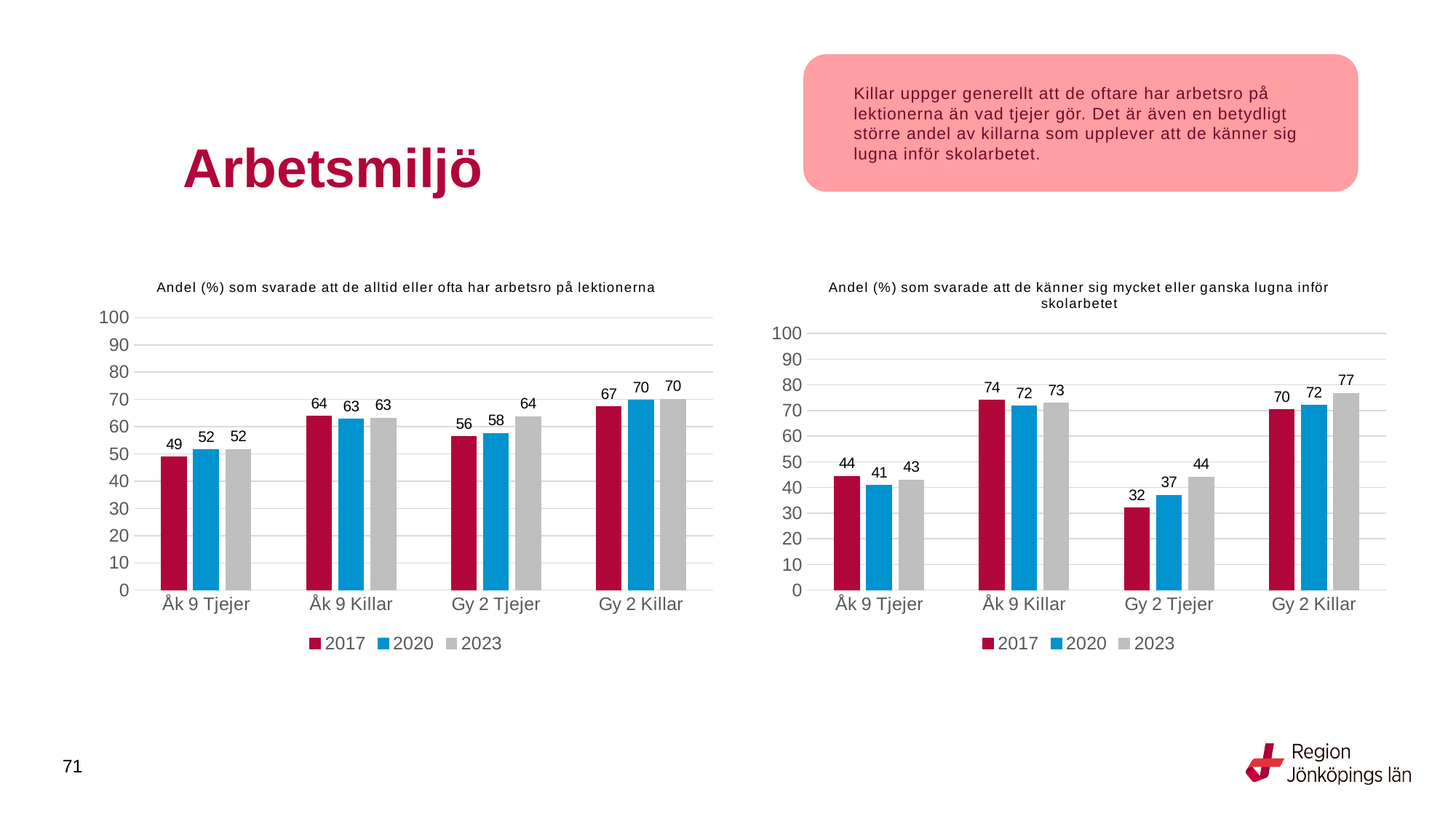
What type of chart is the left chart (arbetsro på lektionerna)? Bar chart How many series does the legend of the left chart list? 3 How many categories are shown on the x axis of the right chart? 4 In the right chart (lugna inför skolarbetet), what is the value for Gy 2 Killar in 2023? 77 In the right chart (lugna inför skolarbetet), what is the value for Gy 2 Tjejer in 2017? 32 In the right chart (lugna inför skolarbetet), what is the difference between Åk 9 Killar and Åk 9 Tjejer in 2023? 30 In the left chart (arbetsro på lektionerna), what is the difference between the 2023 and 2017 values for Gy 2 Tjejer? 8 In the left chart (arbetsro på lektionerna), which category has the highest value in 2023? Gy 2 Killar In the left chart (arbetsro på lektionerna), what is the value for Åk 9 Tjejer in 2017? 49 In the right chart (lugna inför skolarbetet), which category has the lowest value in 2017? Gy 2 Tjejer In the left chart (arbetsro på lektionerna), what is the value for Gy 2 Tjejer in 2023? 64 In the right chart (lugna inför skolarbetet), which is larger: Åk 9 Tjejer in 2017 or Gy 2 Tjejer in 2023? Neither; they are equal (both 44)